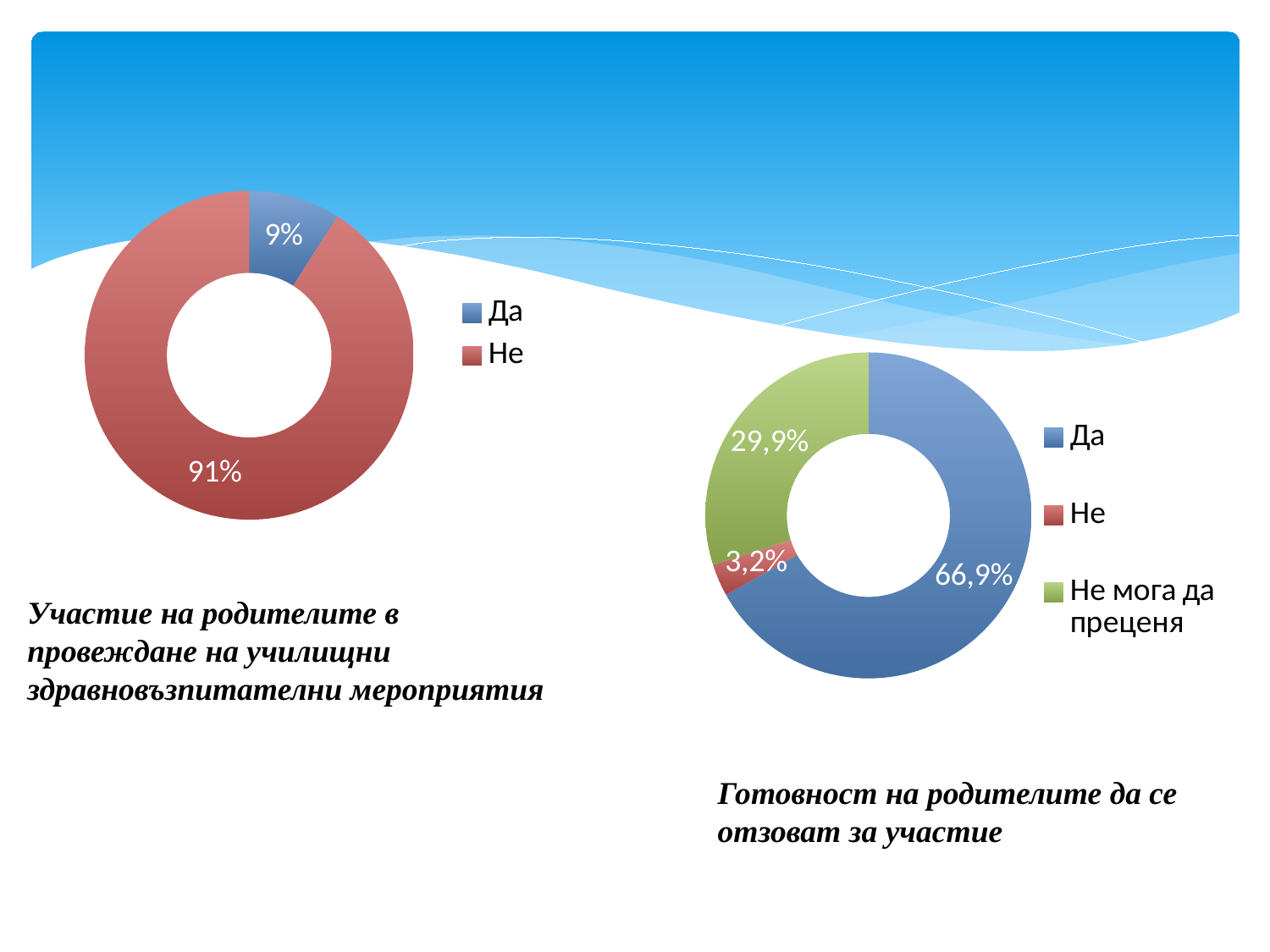
In the right chart (Готовност на родителите да се отзоват за участие), what is the value for "Да"? 66,9% In the left chart (Участие на родителите), what is the difference between the "Не" and "Да" shares? 82% In the left chart (Участие на родителите в провеждане на училищни здравновъзпитателни мероприятия), what is the value for "Не"? 91% In the left chart (Участие на родителите), what is the value for "Да"? 9% In the right chart (Готовност на родителите), which category has the smallest share? Не How many categories does the legend of the right chart (Готовност на родителите) list? 3 In the right chart (Готовност на родителите), what is the value for "Не"? 3,2% What type of chart is the left chart (Участие на родителите)? Doughnut chart In the right chart (Готовност на родителите), which is larger: "Да" or "Не мога да преценя"? Да In the left chart (Участие на родителите), which category has the largest share? Не In the right chart (Готовност на родителите), what is the value for "Не мога да преценя"? 29,9% In the right chart (Готовност на родителите), what is the difference between "Да" and "Не мога да преценя"? 37,0%